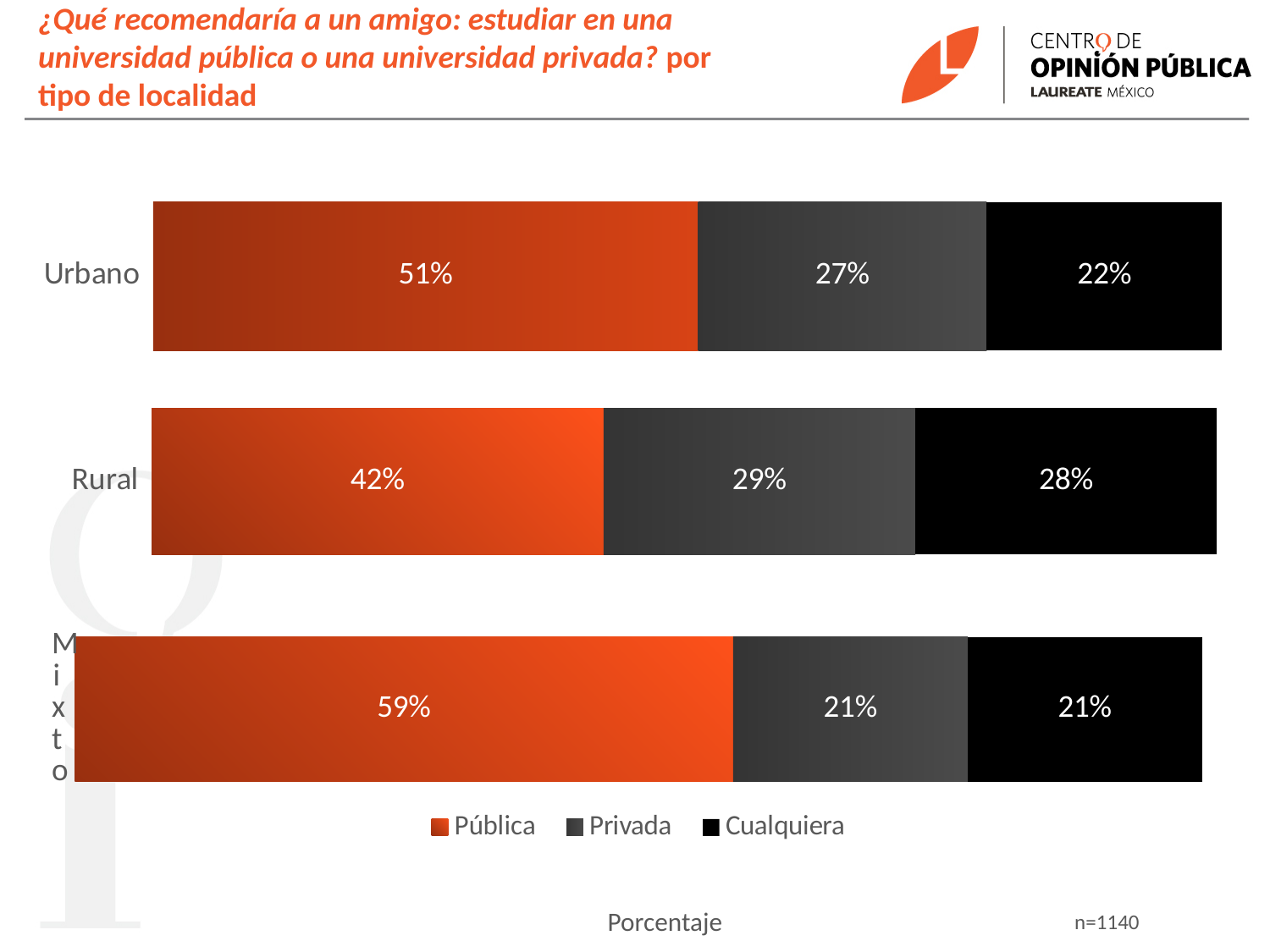
Which is larger: the Cualquiera value for Rural or for Urbano? Rural How many series does the legend list? 3 What is the difference between the Pública values for Mixto and Rural? 17% Which locality type has the lowest Pública value? Rural How many locality categories are shown in the chart? 3 What percentage of Urbano respondents would recommend a Pública university? 51% What is the Cualquiera value for Mixto? 21% What is the Privada value for Rural? 29% What is the total of the stacked bar for Urbano? 100% What kind of chart is shown on the slide? Stacked bar chart What sample size (n) is shown on the slide? n=1140 Which locality type has the highest Pública value? Mixto